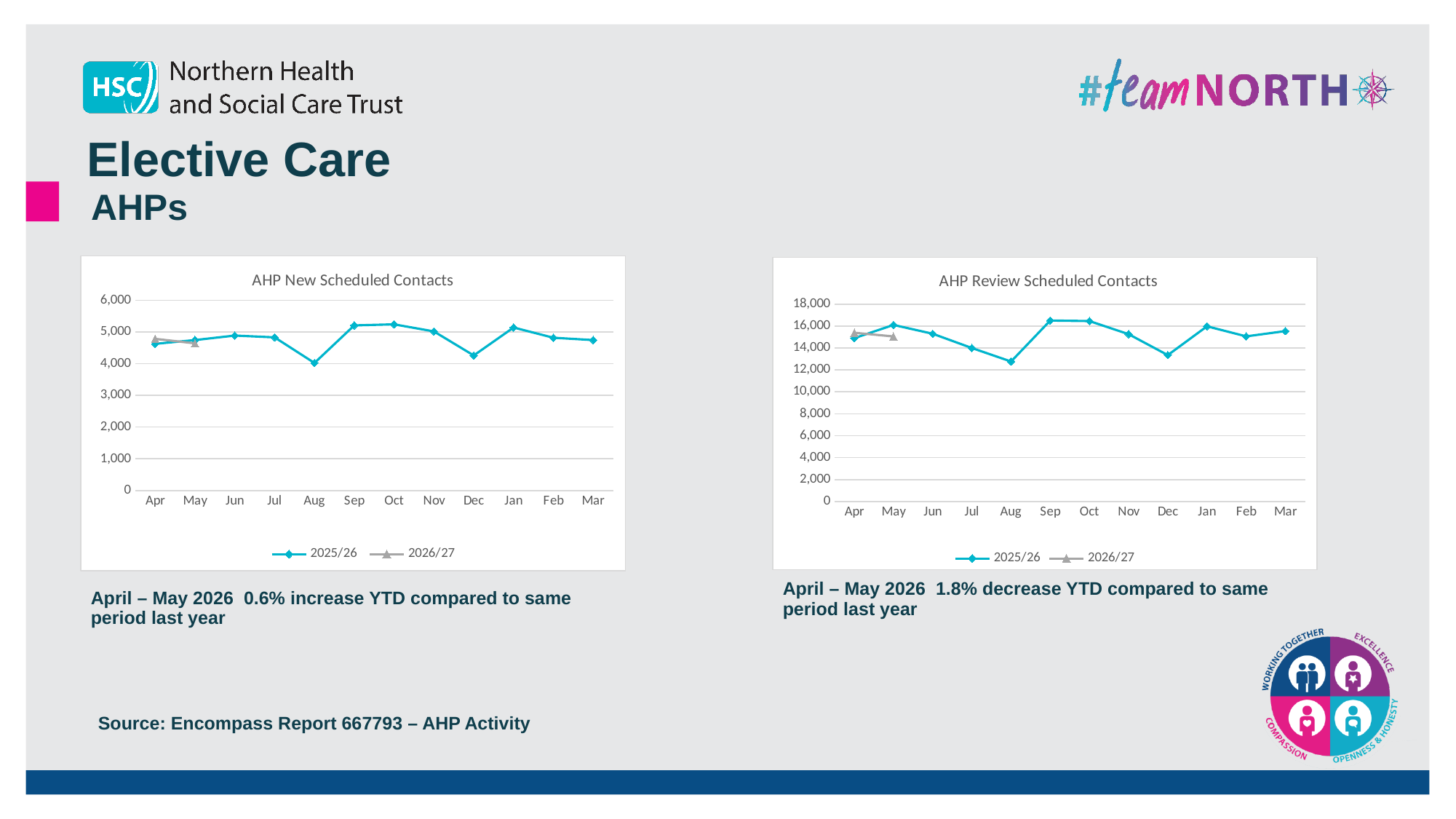
In the 'AHP New Scheduled Contacts' chart, does the 2025/26 line rise or fall from Jul to Aug? fall In the 'AHP Review Scheduled Contacts' chart, is the 2025/26 value for Aug greater or less than 14,000? less How many months are shown on the x axis of the 'AHP New Scheduled Contacts' chart? 12 What is the title of the chart on the right of the slide? AHP Review Scheduled Contacts In the 'AHP Review Scheduled Contacts' chart, which month has the lowest 2025/26 value? Aug How many series does the legend of the 'AHP Review Scheduled Contacts' chart list? 2 What kind of chart is the 'AHP New Scheduled Contacts' chart? line chart In the 'AHP Review Scheduled Contacts' chart, is the 2025/26 value for Sep greater or less than 16,000? greater In the 'AHP New Scheduled Contacts' chart, which month has the lowest 2025/26 value? Aug In the 'AHP Review Scheduled Contacts' chart, which 2025/26 value is larger, Aug or Sep? Sep In the 'AHP New Scheduled Contacts' chart, is the 2025/26 value for Aug greater or less than 5,000? less